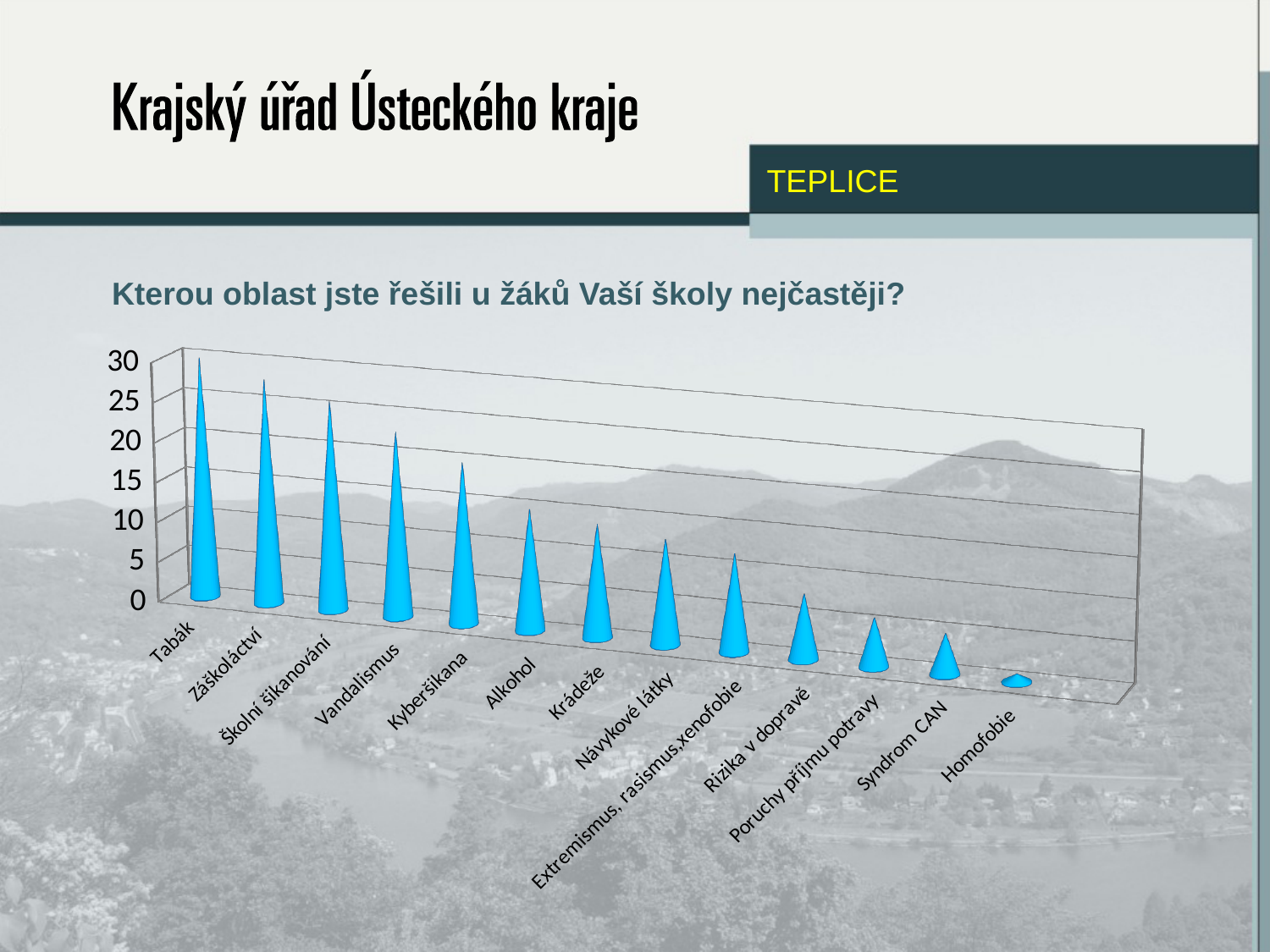
How many categories are shown on the x axis of the chart? 13 Is the value for Tabák greater or less than 25? greater Which category has the highest value in the chart? Tabák Which is larger, the value for Rizika v dopravě or the value for Kyberšikana? Kyberšikana Which category has the lowest value in the chart? Homofobie Is the value for Vandalismus greater or less than 15? greater Is the value for Kyberšikana greater or less than 10? greater What is the title of the chart? Kterou oblast jste řešili u žáků Vaší školy nejčastěji? Do the values rise or fall moving from left to right along the x axis? fall Which is larger, the value for Záškoláctví or the value for Krádeže? Záškoláctví